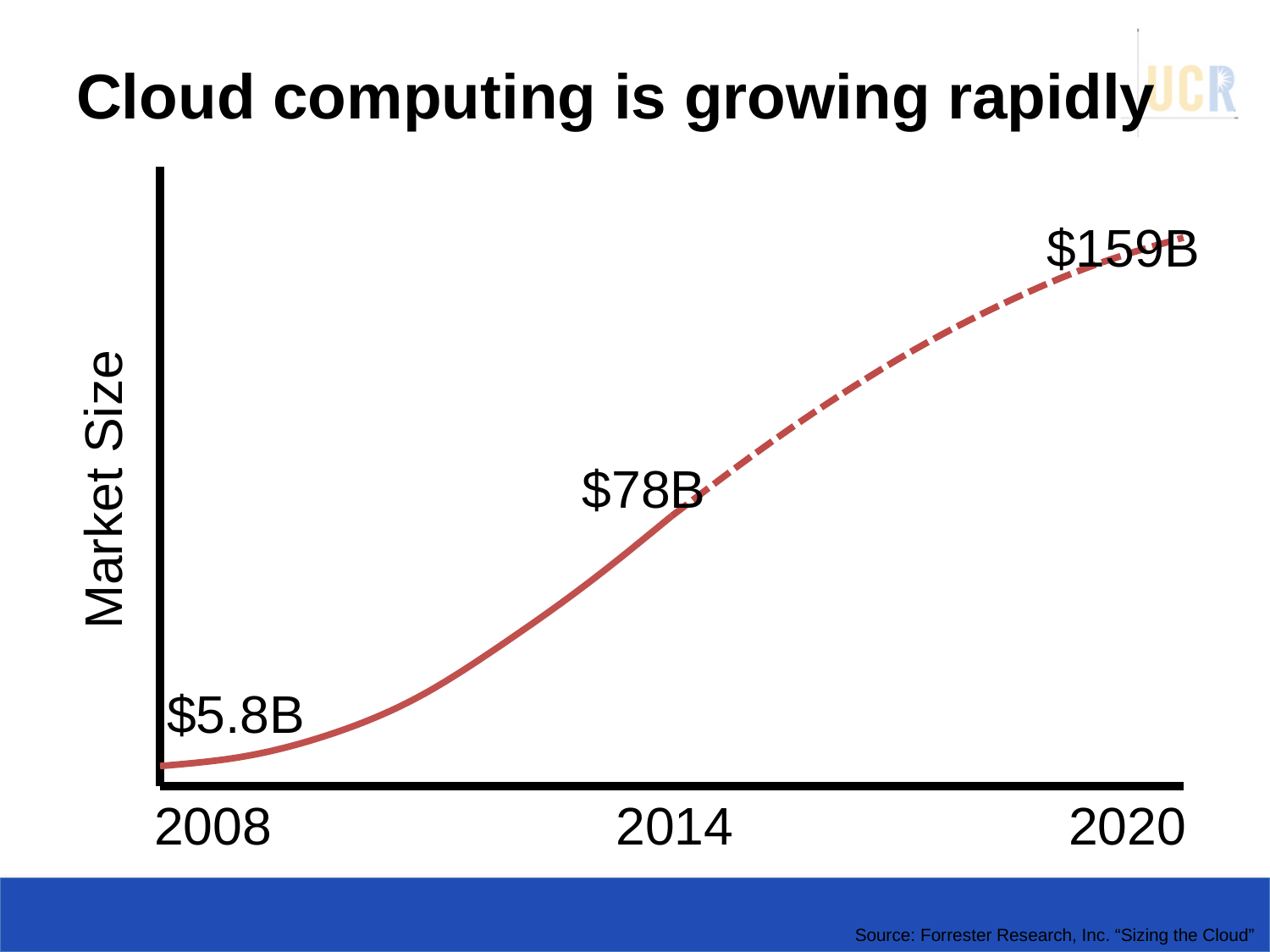
What is the market size shown for 2008? $5.8B What is the label on the y axis? Market Size What is the difference in market size between 2020 and 2014? $81B Which is larger, the market size in 2014 or in 2008? 2014 Does the market size rise or fall from 2008 to 2020? Rise Which year has the highest market size? 2020 What kind of chart is this? Line chart What is the market size shown for 2020? $159B How many years are labelled on the x axis? 3 What is the market size shown for 2014? $78B Which year has the lowest market size? 2008 What is the title of the slide? Cloud computing is growing rapidly